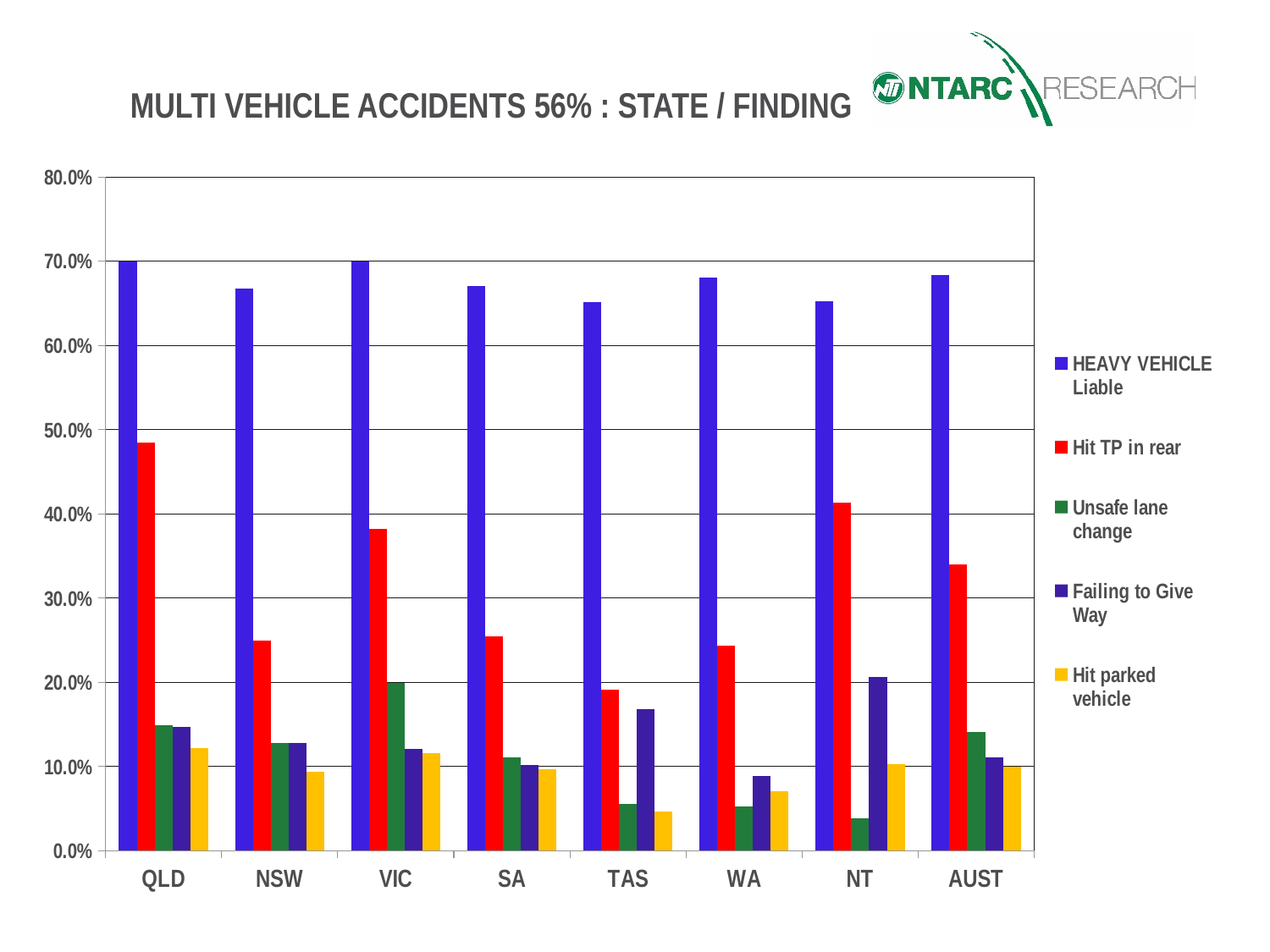
Which category has the lowest value for Unsafe lane change? NT Which is larger, the Hit TP in rear value for VIC or for NSW? VIC Which category has the highest value for Failing to Give Way? NT What colour represents the Hit parked vehicle series in the legend? yellow What kind of chart is shown on the slide? bar chart Is the Hit TP in rear value for QLD greater or less than 40.0%? greater Which category has the highest value for Unsafe lane change? VIC How many series does the legend list? 5 Which category has the highest value for Hit TP in rear? QLD Is the Unsafe lane change value for VIC greater or less than 10.0%? greater Is the Hit parked vehicle value for TAS greater or less than 10.0%? less How many state/region categories are shown along the x axis? 8